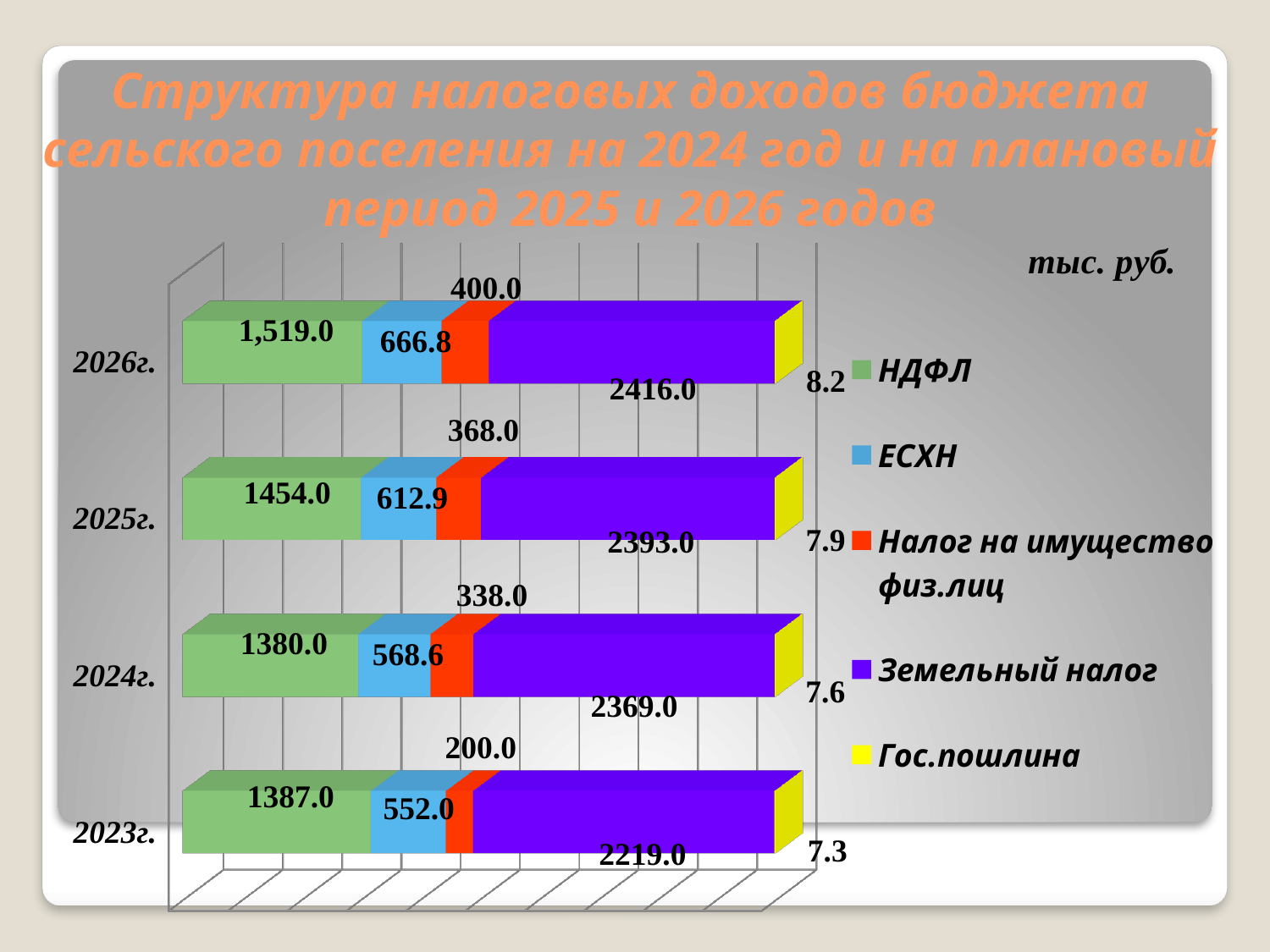
How many series does the legend list? 5 What is the value of Земельный налог for 2024г.? 2369.0 What kind of chart is shown on the slide? stacked bar chart How many years (categories) are shown on the chart? 4 What is the difference between the Земельный налог values for 2026г. and 2023г.? 197.0 Which is larger: ЕСХН for 2025г. or ЕСХН for 2024г.? ЕСХН for 2025г. In which year is the value of Земельный налог the highest? 2026г. What is the value of Налог на имущество физ.лиц for 2025г.? 368.0 What is the value of НДФЛ for 2026г.? 1,519.0 In which year is the value of Налог на имущество физ.лиц the lowest? 2023г. What is the value of Гос.пошлина for 2023г.? 7.3 What is the total of the stacked bar for 2026г.? 5010.0